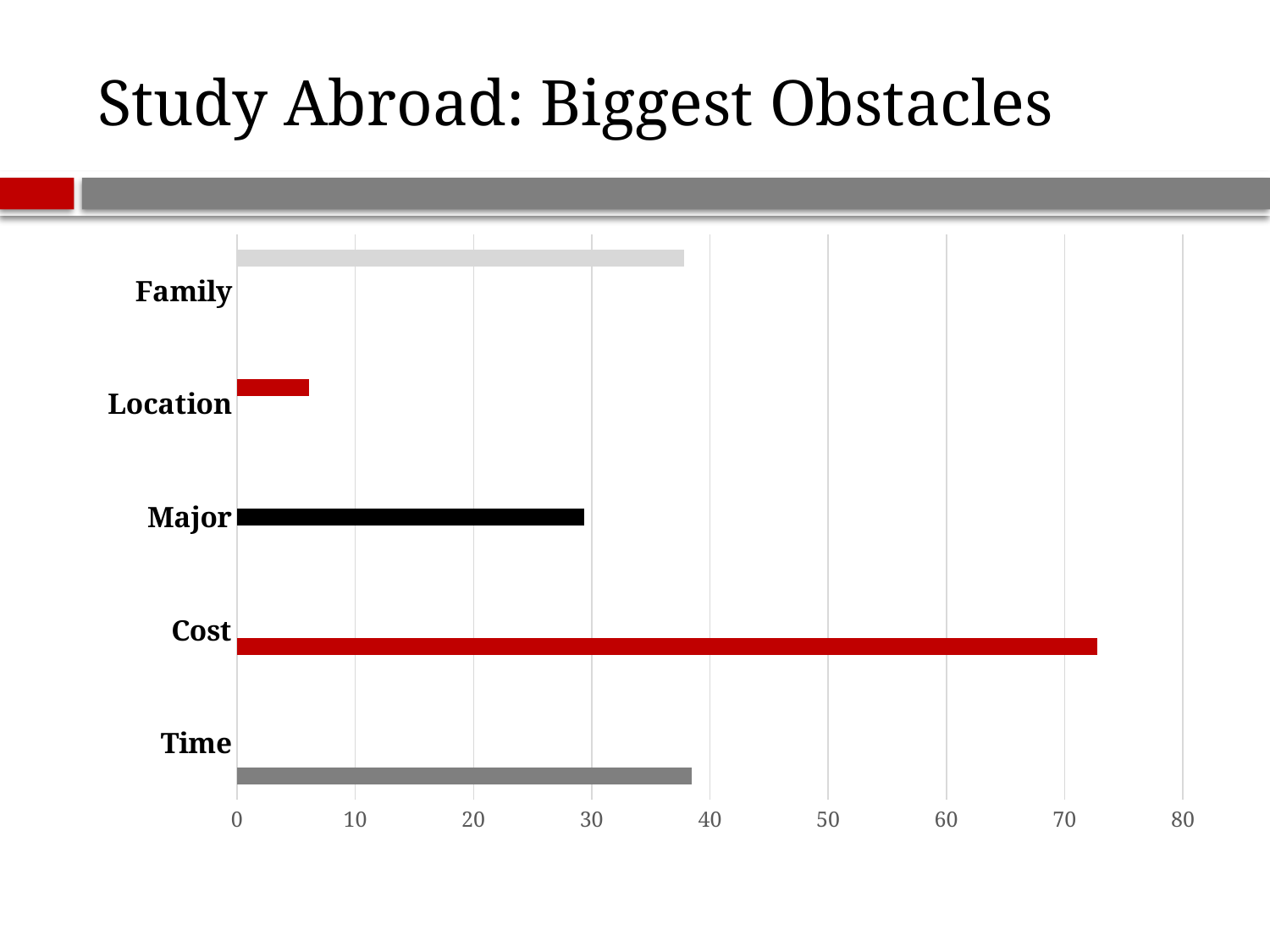
Which category has the highest value? Cost Is the value for Location greater or less than 10? less What is the title of the slide containing the chart? Study Abroad: Biggest Obstacles What colour is the bar for Major? black What kind of chart is shown on the slide? bar chart Is the value for Family greater or less than 30? greater Which is larger, the value for Major or the value for Location? Major Is the value for Cost greater or less than 70? greater How many categories are plotted in the chart? 5 Which category has the lowest value? Location Which is larger, the value for Cost or the value for Major? Cost